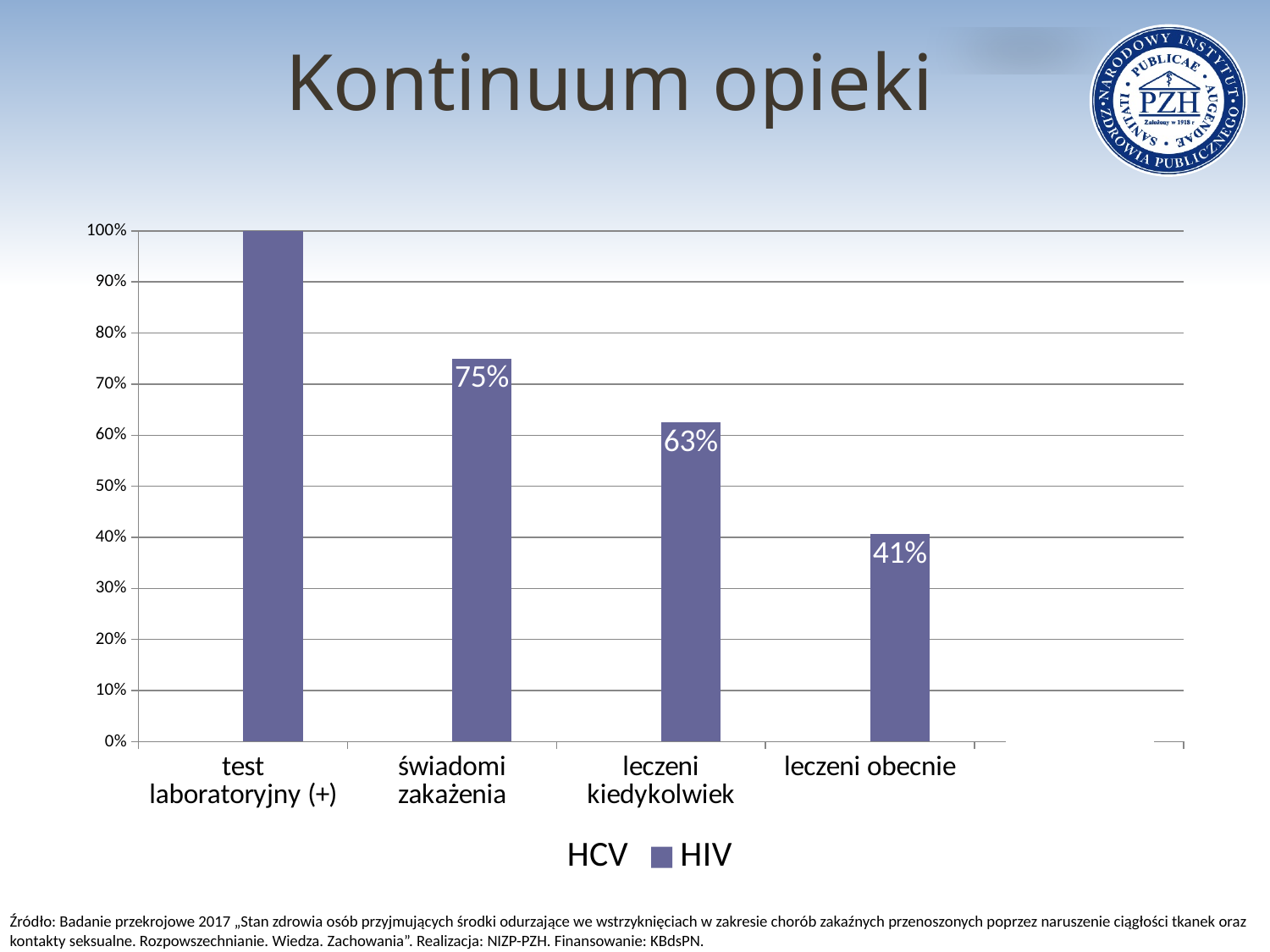
Which is larger, leczeni kiedykolwiek or leczeni obecnie? leczeni kiedykolwiek What is the value for świadomi zakażenia? 75% What kind of chart is this? bar chart How many categories are shown on the x axis? 4 What is the difference between świadomi zakażenia and leczeni kiedykolwiek? 12% What is the difference between świadomi zakażenia and leczeni obecnie? 34% Which category has the highest value? test laboratoryjny (+) What is the value for leczeni obecnie? 41% Which category has the lowest value? leczeni obecnie What is the value for test laboratoryjny (+)? 100% Do the values rise or fall from left to right along the x axis? fall What is the value for leczeni kiedykolwiek? 63%